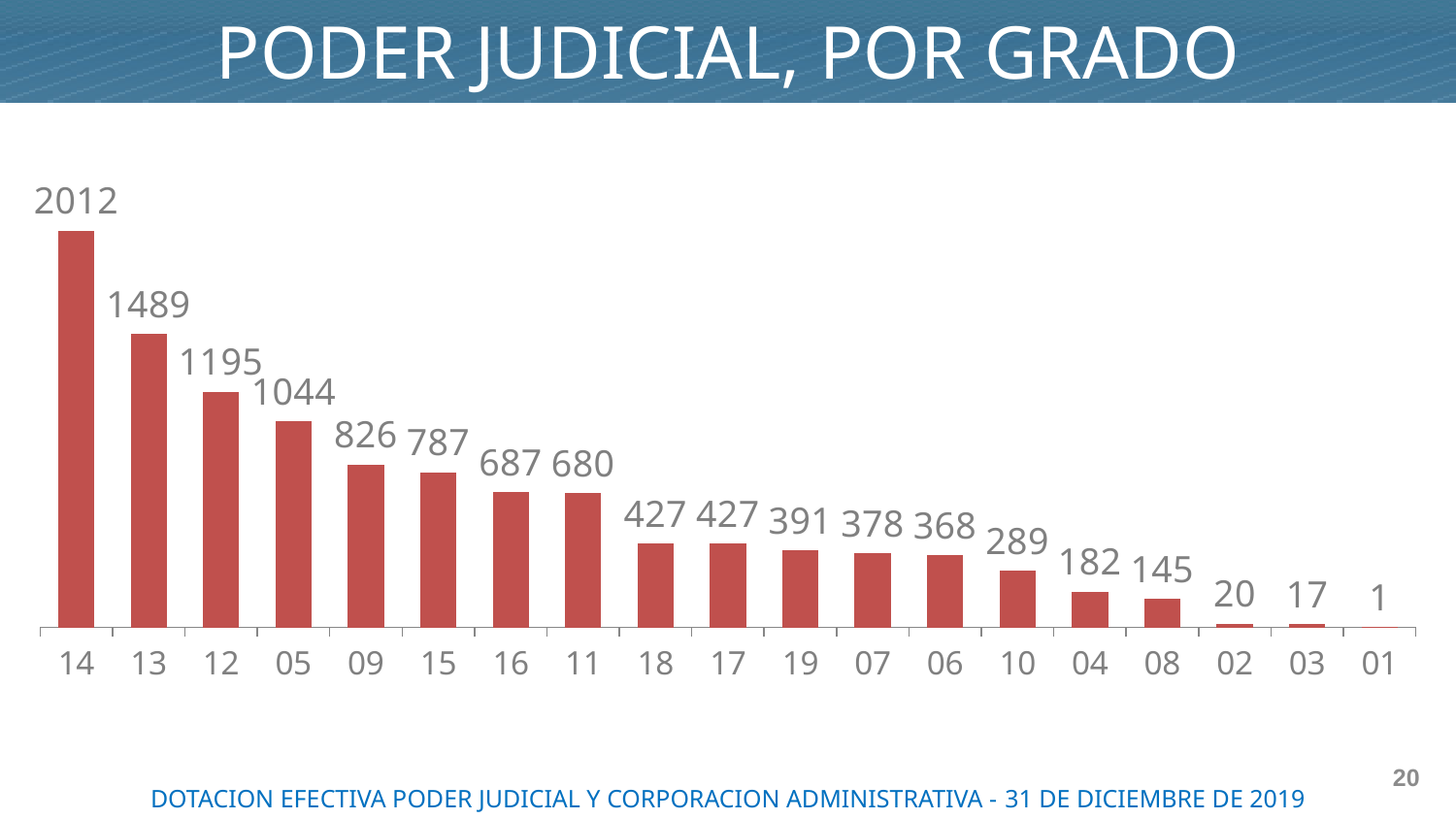
What is the value for grado 09? 826 What is the value for grado 14? 2012 Which has a larger value, grado 05 or grado 15? 05 Which has a larger value, grado 10 or grado 08? 10 What kind of chart is shown on the slide? bar chart Which grado has the highest value? 14 What is the title of the chart on the slide? PODER JUDICIAL, POR GRADO What is the value for grado 04? 182 What is the difference between the values for grado 13 and grado 12? 294 What is the difference between the values for grado 16 and grado 11? 7 How many grados are shown on the x axis? 19 Which grado has the lowest value? 01